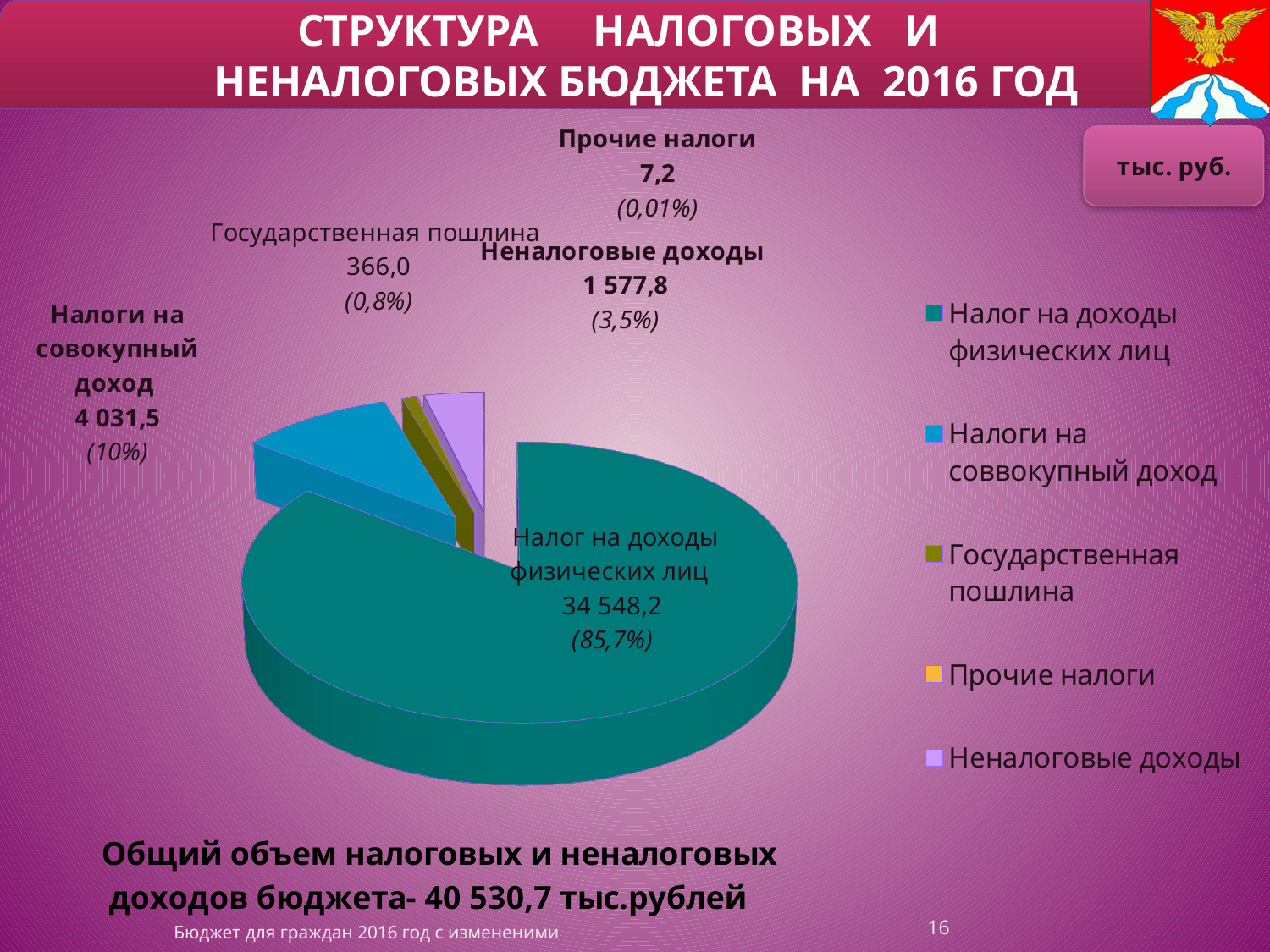
Which category has the largest slice of the pie? Налог на доходы физических лиц Which category has the smallest slice of the pie? Прочие налоги What is the value for Государственная пошлина? 366,0 What is the value for Налог на доходы физических лиц? 34 548,2 How many categories does the legend list? 5 What is the value for Прочие налоги? 7,2 What kind of chart is shown on the slide? pie chart What share of the pie does Неналоговые доходы represent? 3,5% What is the value for Неналоговые доходы? 1 577,8 What share of the pie does Налог на доходы физических лиц represent? 85,7% Which is larger, Налоги на совокупный доход or Неналоговые доходы? Налоги на совокупный доход What is the value for Налоги на совокупный доход? 4 031,5